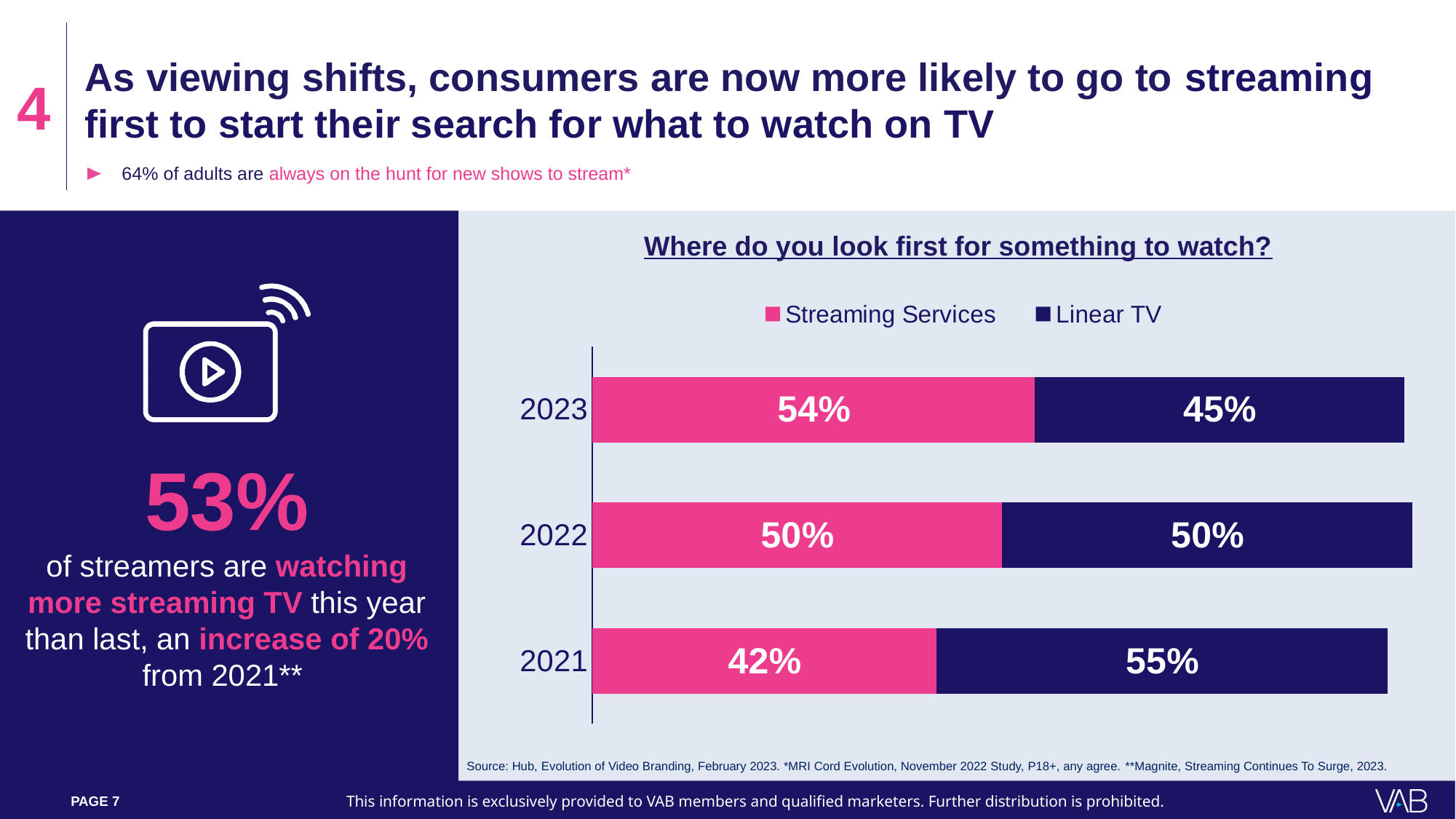
What kind of chart is shown? Stacked bar chart In which year is the Streaming Services value highest? 2023 In which year is the Linear TV value lowest? 2023 What is the difference between the Streaming Services values for 2023 and 2021? 12 percentage points What is the Streaming Services value for 2022? 50% How many series does the legend list? 2 Does the Streaming Services value rise or fall from 2021 to 2023? Rise In 2021, which is larger: Streaming Services or Linear TV? Linear TV What is the Linear TV value for 2021? 55% What is the title of the chart? Where do you look first for something to watch? What percentage of respondents looked first at Streaming Services in 2023? 54% How many years are shown on the chart? 3